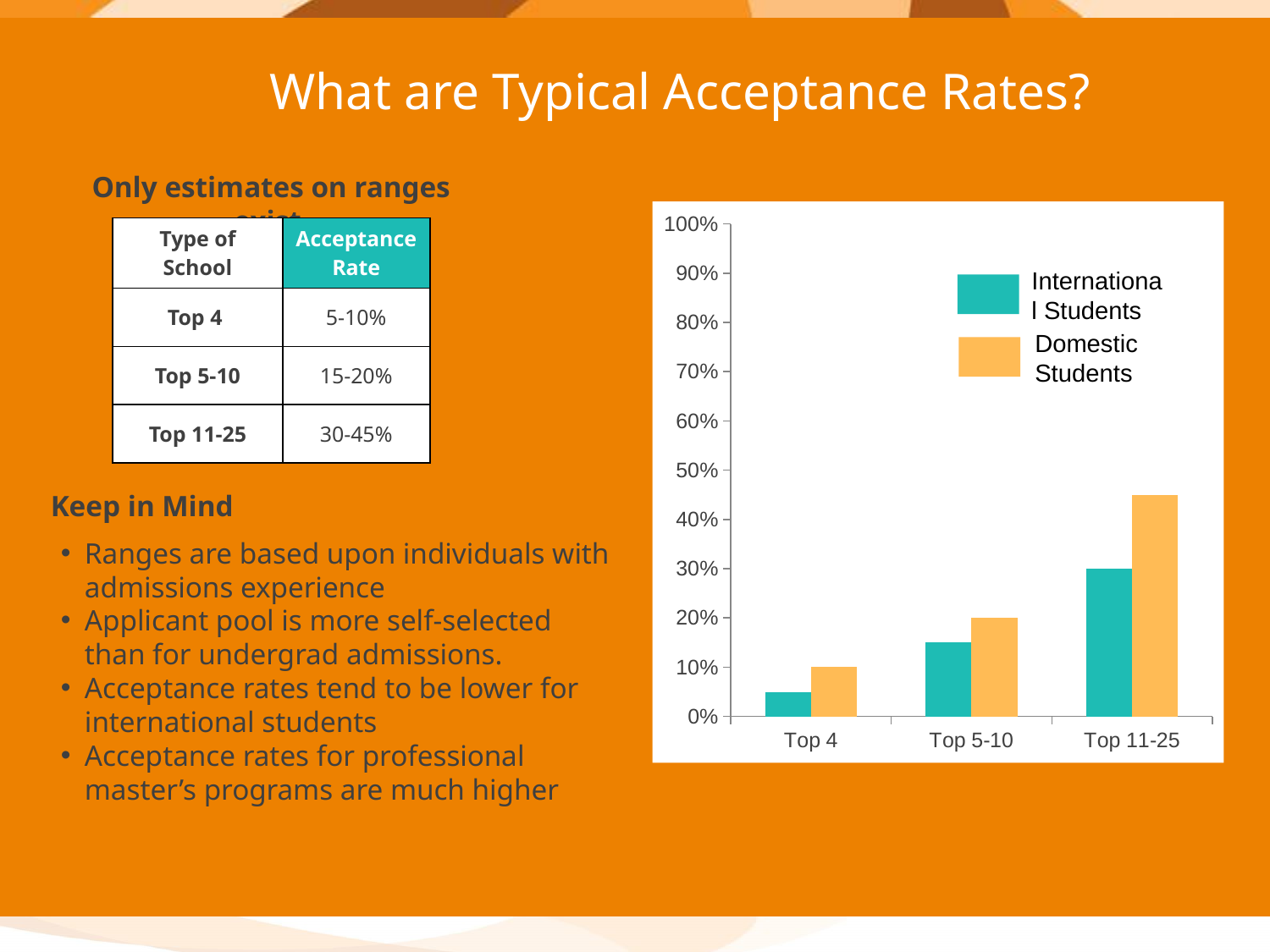
Which category has the lowest value for International Students? Top 4 Is the value for International Students in the Top 5-10 category greater or less than 20%? less What is the value for International Students in the Top 11-25 category? 30% Which category has the highest value for Domestic Students? Top 11-25 Is the value for Domestic Students in the Top 11-25 category greater or less than 40%? greater Is the value for International Students in the Top 4 category greater or less than 10%? less How many categories are shown on the x axis of the chart? 3 How many series does the chart legend list? 2 In the Top 5-10 category, which is larger: International Students or Domestic Students? Domestic Students What is the value for Domestic Students in the Top 4 category? 10% What is the value for Domestic Students in the Top 5-10 category? 20% What kind of chart is shown on the slide? bar chart